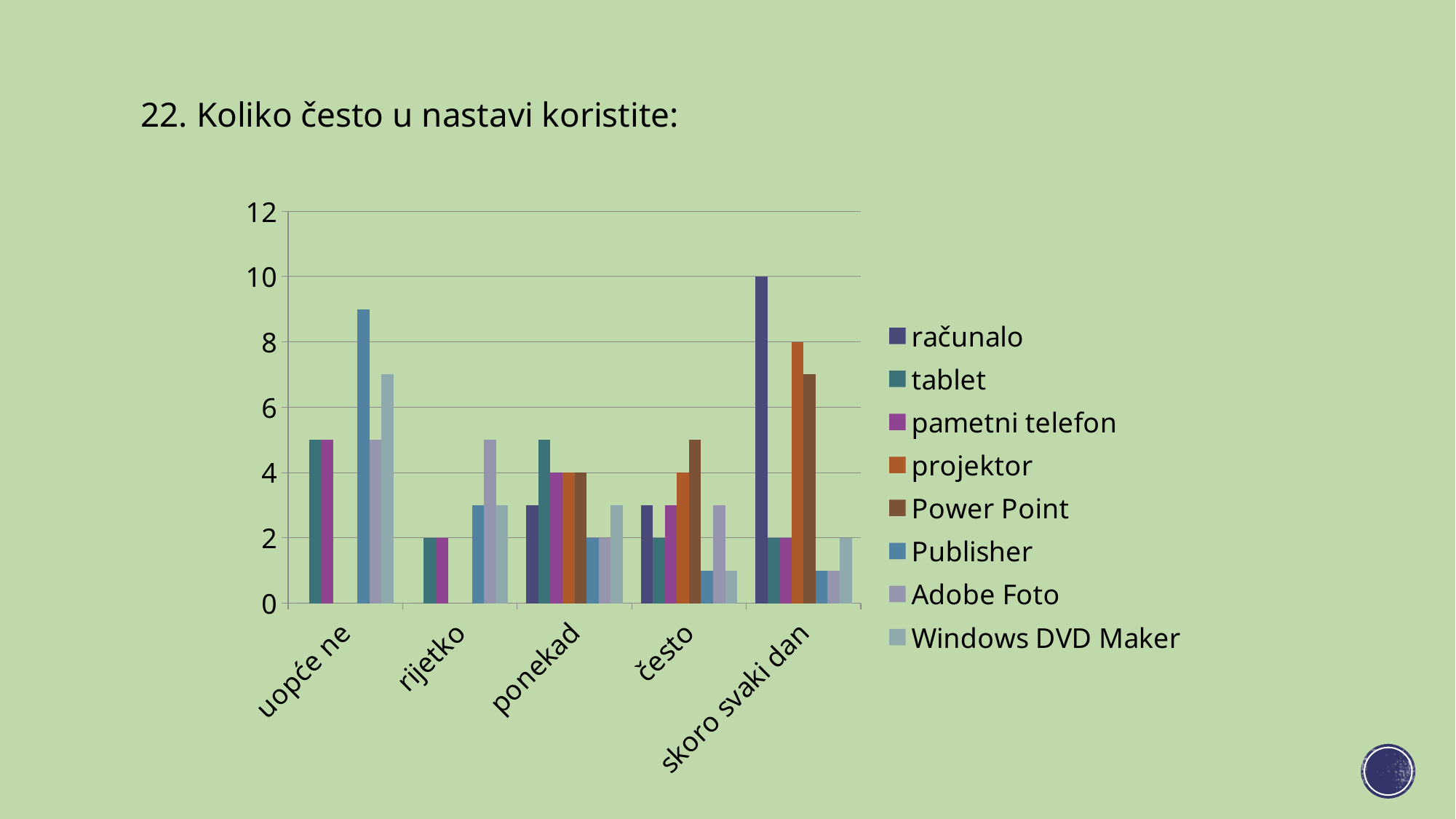
How many series does the legend list? 8 What type of chart is shown on the slide? bar chart What is the value for računalo in the category skoro svaki dan? 10 What is the value for pametni telefon in the category ponekad? 4 Is the value for Publisher in the category uopće ne greater or less than 8? greater In the category uopće ne, which is larger: Publisher or Windows DVD Maker? Publisher Is the value for Power Point in the category skoro svaki dan greater or less than 6? greater How many categories are shown on the x axis? 5 What is the value for tablet in the category rijetko? 2 What is the difference between računalo and projektor in the category skoro svaki dan? 2 What is the value for projektor in the category skoro svaki dan? 8 Which series has the highest value in the category uopće ne? Publisher